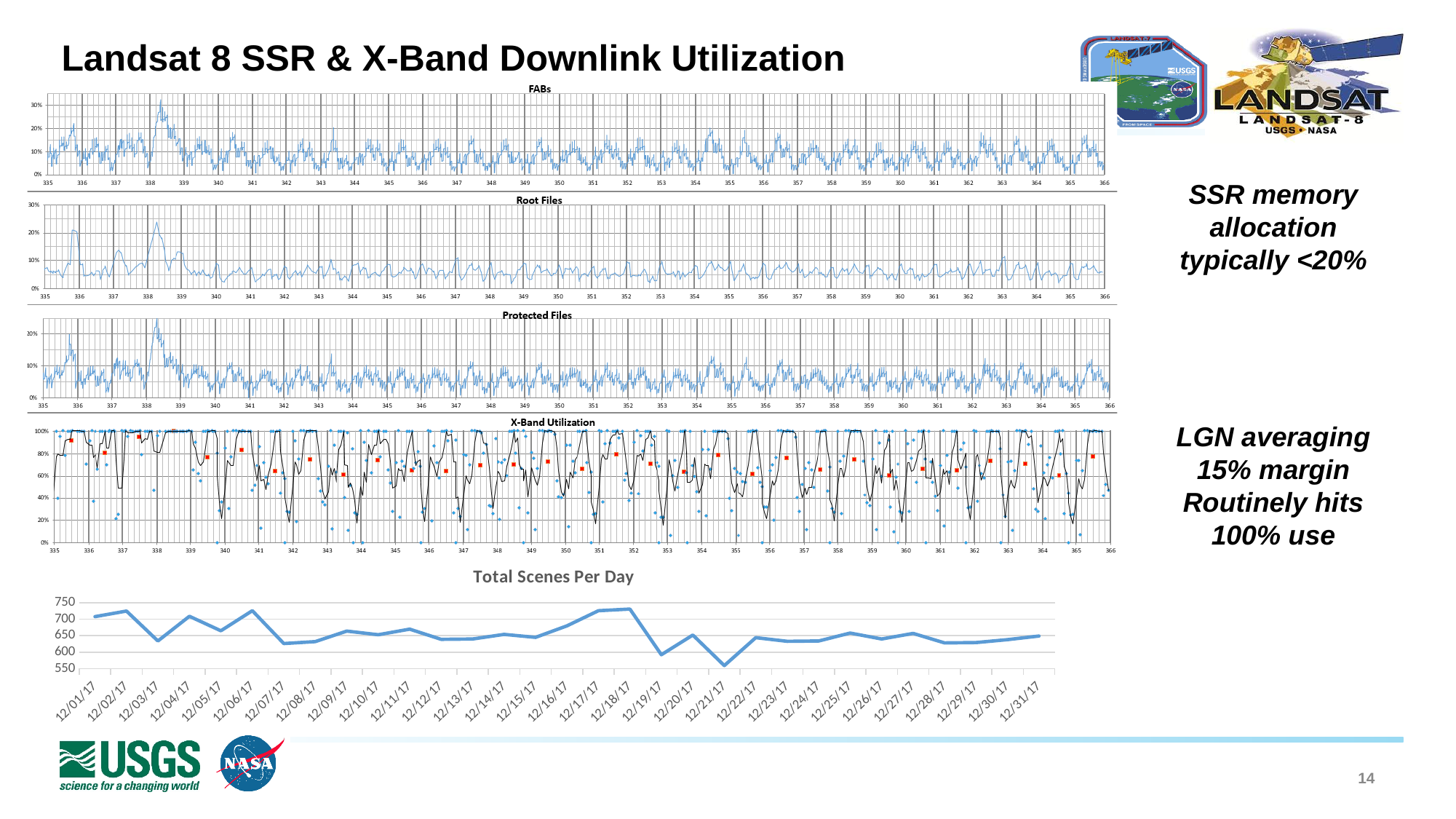
What is the title of the fourth chart from the top on the slide? X-Band Utilization In the Total Scenes Per Day chart, which date has the lowest value? 12/21/17 In the Total Scenes Per Day chart, which is larger, the value for 12/18/17 or the value for 12/21/17? 12/18/17 In the Total Scenes Per Day chart, which is larger, the value for 12/02/17 or the value for 12/03/17? 12/02/17 How many charts are shown on the slide? 5 What is the highest value shown on the y axis of the X-Band Utilization chart? 100% In the Total Scenes Per Day chart, is the value for 12/07/17 greater or less than 650? less What type of chart is the Total Scenes Per Day chart? line chart In the Total Scenes Per Day chart, is the value for 12/02/17 greater or less than 700? greater In the Total Scenes Per Day chart, how many dates are plotted along the x axis? 31 In the Total Scenes Per Day chart, is the value for 12/18/17 greater or less than 700? greater